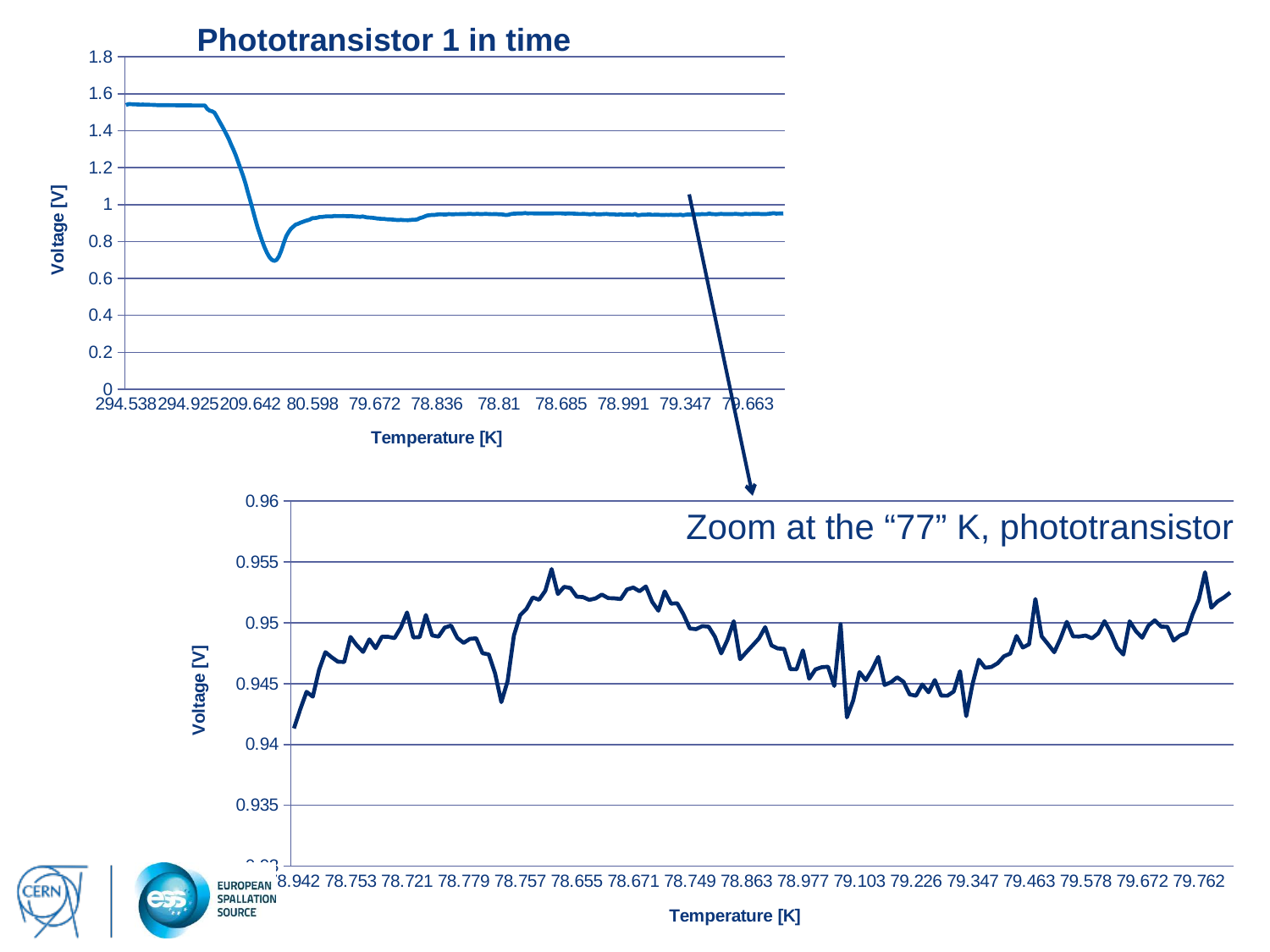
In the bottom zoom chart, what is the highest value shown on the y axis? 0.96 What kind of chart is the top chart titled "Phototransistor 1 in time"? line chart In the top chart, is the voltage at the first x-axis tick (294.538) greater or less than 1.4? greater How many x-axis tick labels does the top chart show? 11 In the top chart, is the voltage at the last x-axis tick (79.663) greater or less than 1? less In the bottom zoom chart, is the voltage at the first point (left end of the line) greater or less than 0.945? less What kind of chart is the bottom chart (the zoom at the "77" K)? line chart What is the title of the top chart? Phototransistor 1 in time In the top chart, does the voltage rise or fall between the first tick (294.538) and the dip near 80.598? fall In the top chart, what is the label of the x axis? Temperature [K]